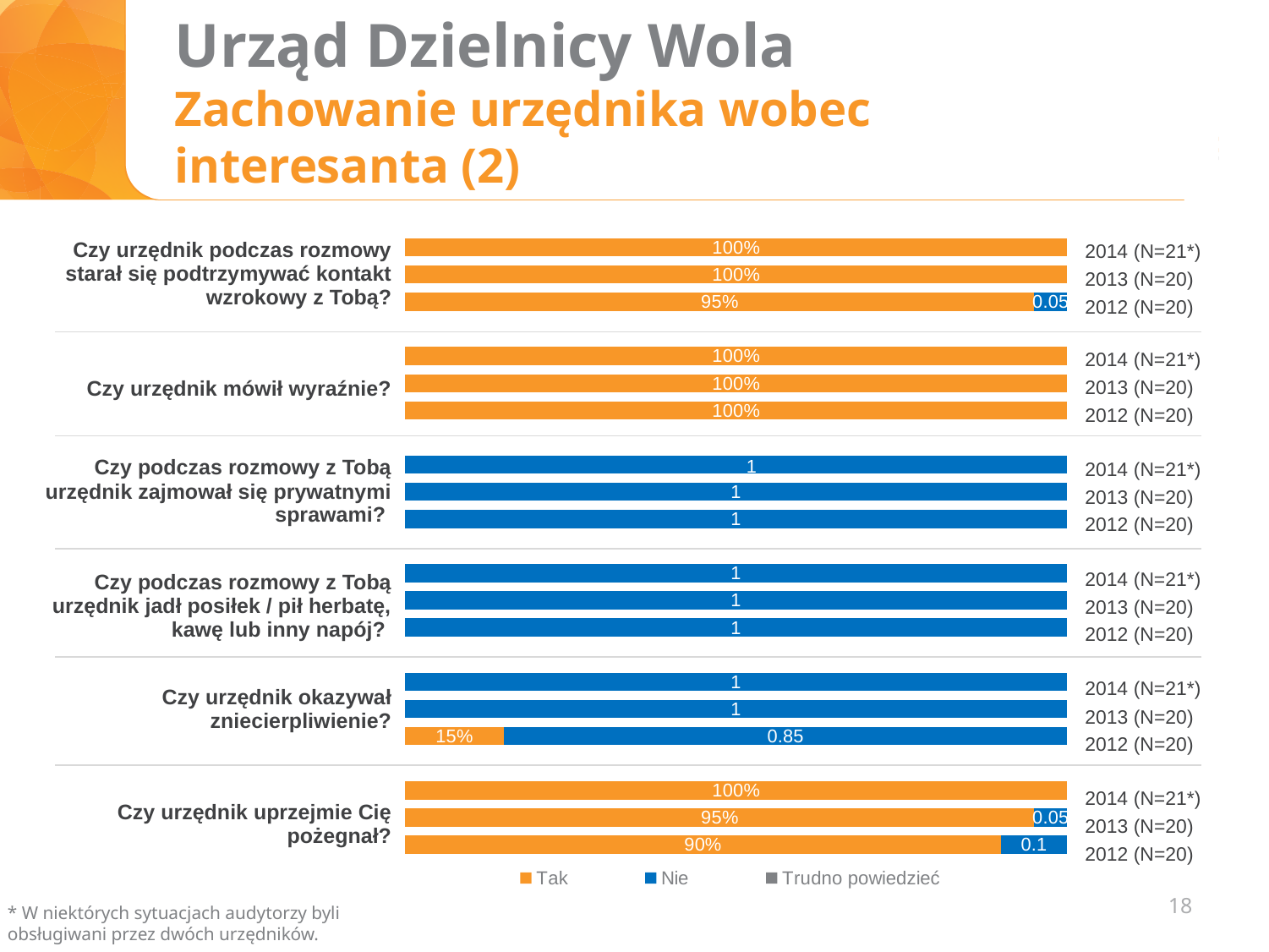
What is the 'Tak' value for 2012 (N=20) for the question 'Czy urzędnik uprzejmie Cię pożegnał?'? 90% What is the 'Tak' value for 2012 (N=20) for the question 'Czy urzędnik podczas rozmowy starał się podtrzymywać kontakt wzrokowy z Tobą?'? 95% For the question 'Czy urzędnik uprzejmie Cię pożegnał?', which year has the lowest 'Tak' value? 2012 (N=20) What is the 'Nie' value for 2012 (N=20) for the question 'Czy urzędnik podczas rozmowy starał się podtrzymywać kontakt wzrokowy z Tobą?'? 0.05 How many series does the legend list? 3 What kind of chart is shown on the slide? bar chart What are the legend entries of the chart? Tak, Nie, Trudno powiedzieć What is the 'Tak' value for 2012 (N=20) for the question 'Czy urzędnik okazywał zniecierpliwienie?'? 15% What is the 'Nie' value for 2013 (N=20) for the question 'Czy podczas rozmowy z Tobą urzędnik zajmował się prywatnymi sprawami?'? 1 For the question 'Czy urzędnik uprzejmie Cię pożegnał?', is the 'Tak' value larger for 2014 (N=21*) or for 2013 (N=20)? 2014 (N=21*) What is the 'Nie' value for 2012 (N=20) for the question 'Czy urzędnik okazywał zniecierpliwienie?'? 0.85 What is the 'Tak' value for 2014 (N=21*) for the question 'Czy urzędnik mówił wyraźnie?'? 100%